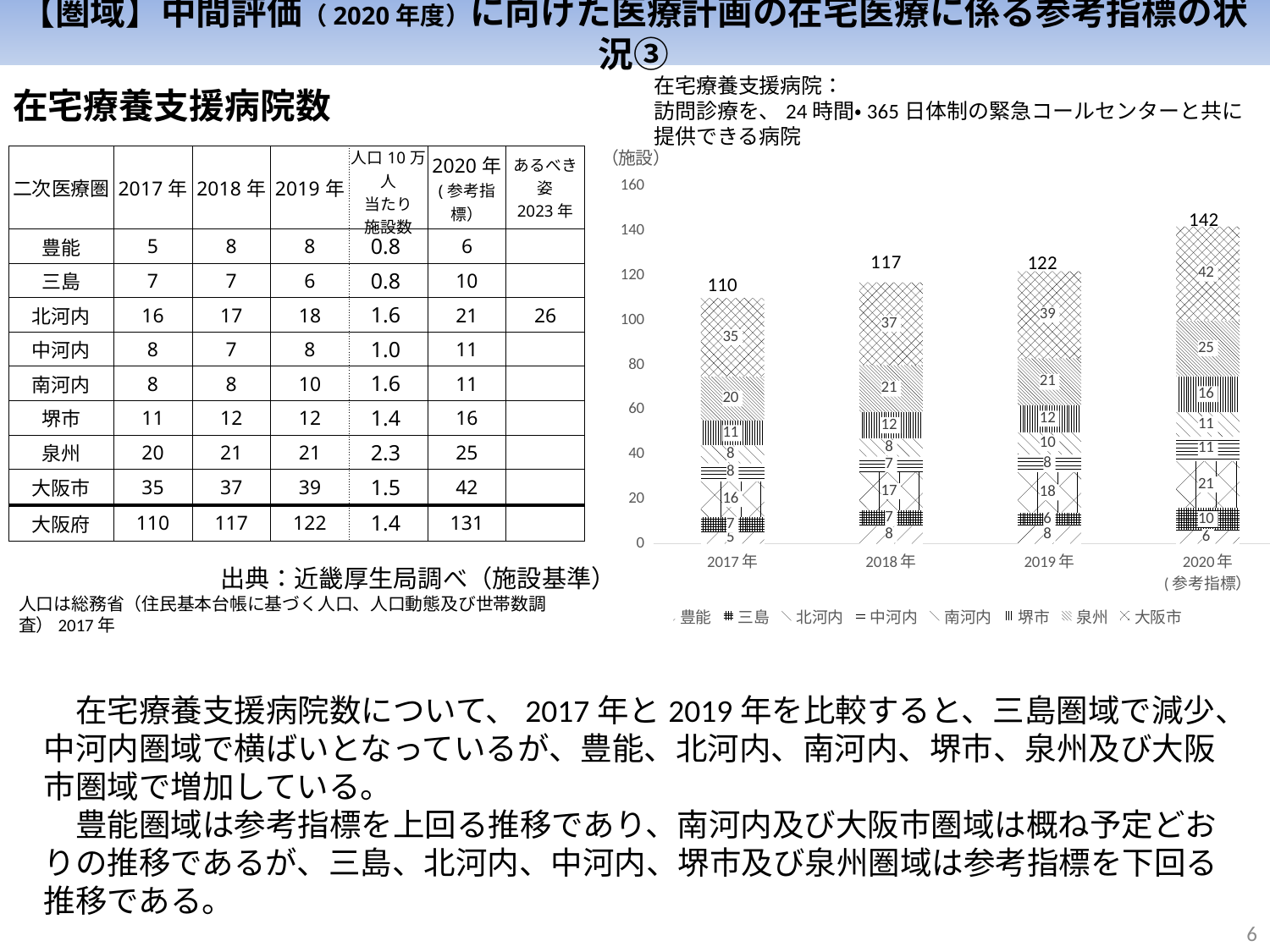
What is the total value of the stacked bar for 2020年(参考指標)? 142 Which year has the lowest total in the chart? 2017年 What is the value of the 泉州 segment in the 2020年(参考指標) bar? 25 Do the bar totals rise or fall from 2017年 to 2020年(参考指標)? rise How many series does the chart legend list? 8 What is the value of the 北河内 segment in the 2018年 bar? 17 What is the difference between the total for 2019年 and the total for 2017年? 12 Which year has the highest total in the chart? 2020年(参考指標) What is the total value of the stacked bar for 2017年? 110 What is the value of the 大阪市 segment in the 2019年 bar? 39 How many bars (year categories) are plotted in the chart? 4 What type of chart is shown on the slide? stacked bar chart